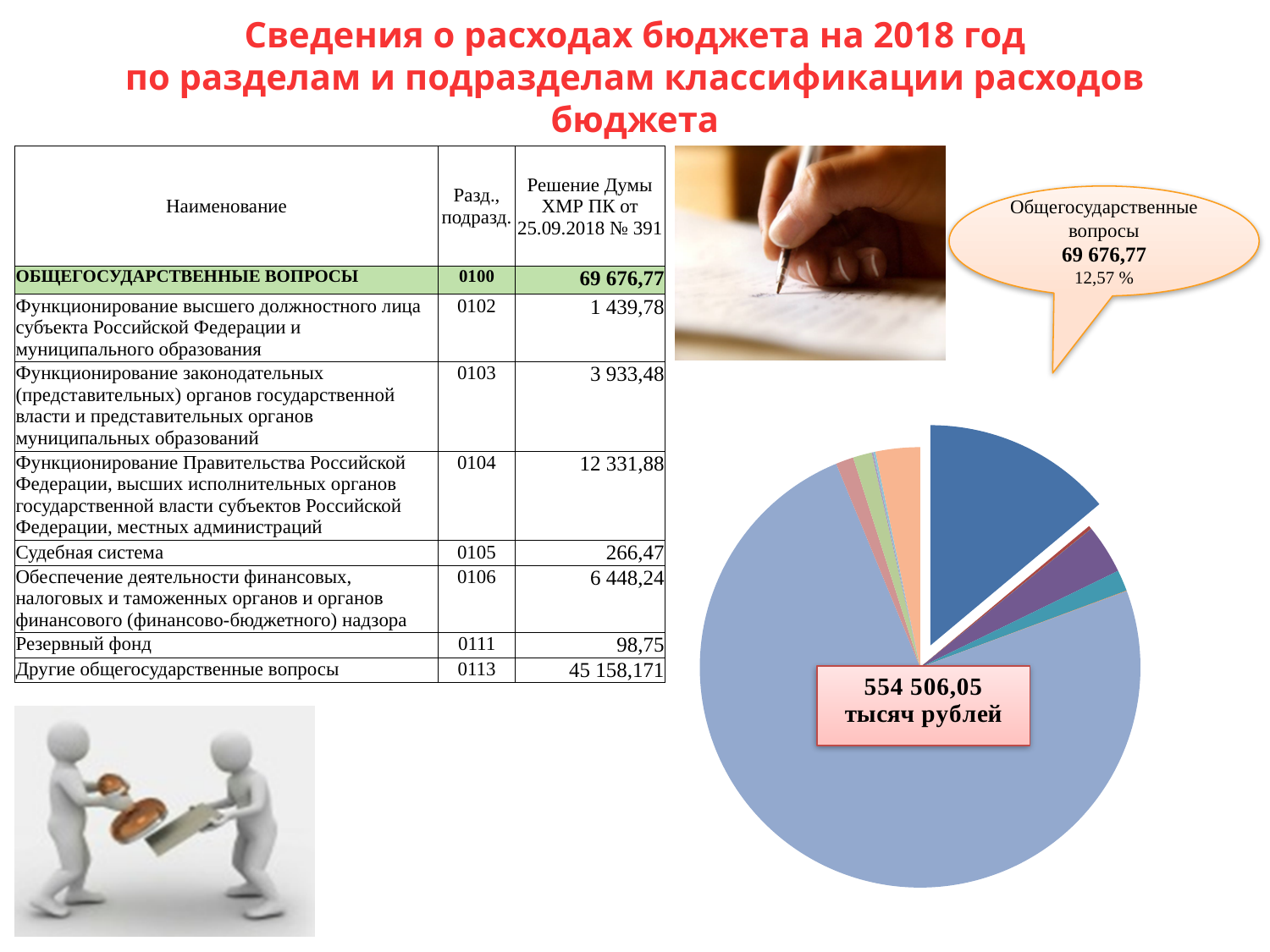
Does the pie chart on the slide include a legend? No Is the share of the "Общегосударственные вопросы" slice in the pie chart greater or less than 50%? less In the pie chart, what value is given in the callout for the slice "Общегосударственные вопросы"? 69 676,77 What kind of chart is shown on the right side of the slide? pie chart What total value is printed in the centre of the pie chart? 554 506,05 тысяч рублей In the pie chart, what share of the total does the slice labelled "Общегосударственные вопросы" represent? 12,57 % In the pie chart, which slice is pulled out (exploded) from the rest of the pie? Общегосударственные вопросы